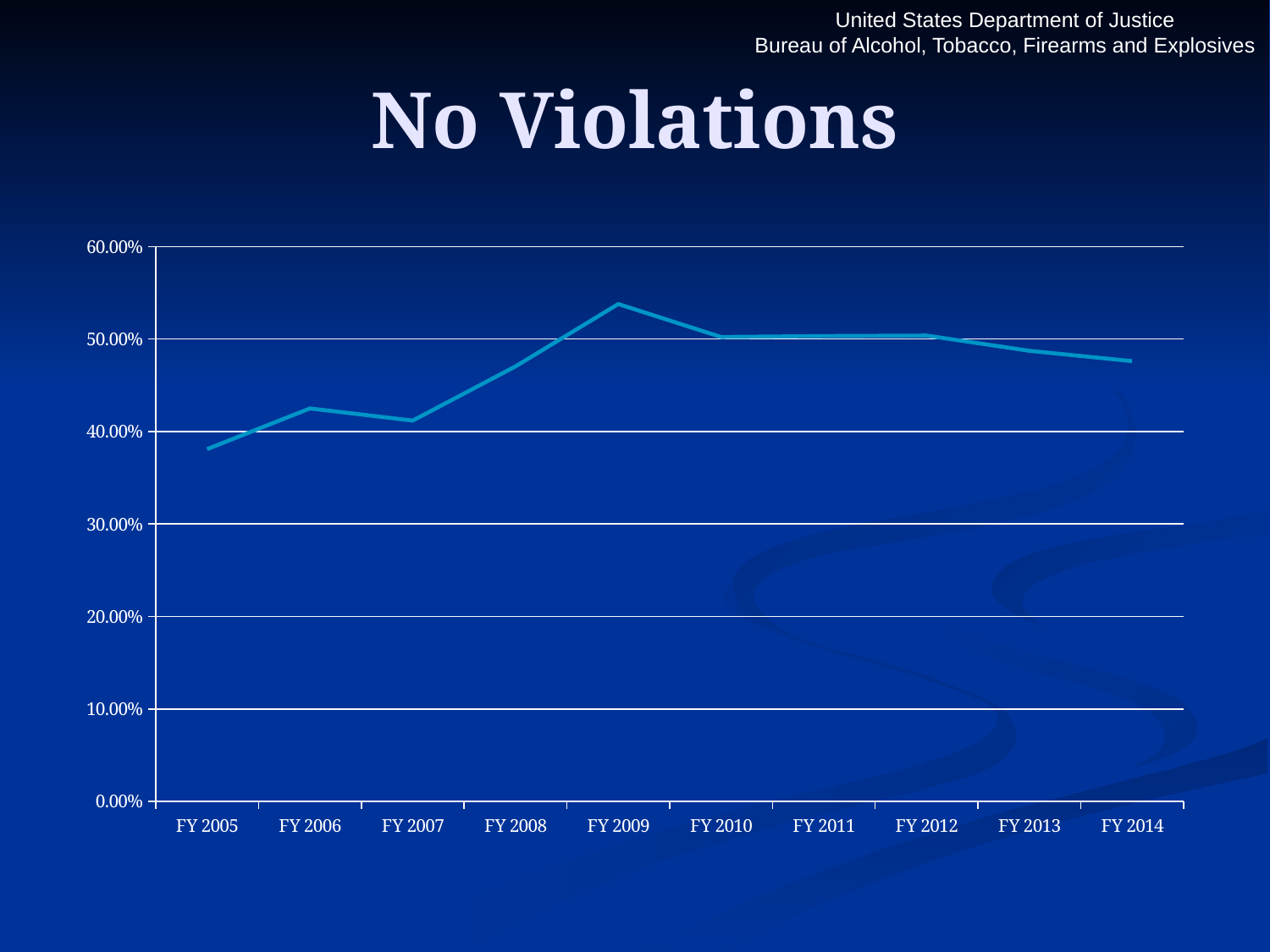
Which fiscal year has the highest value? FY 2009 How many fiscal years are plotted on the x axis? 10 What is the highest value shown on the y axis? 60.00% Does the line rise or fall from FY 2005 to FY 2009? rise Which fiscal year has the lowest value? FY 2005 Is the value for FY 2008 greater or less than 40.00%? greater Is the value for FY 2014 greater or less than 50.00%? less Which is larger, the value for FY 2009 or the value for FY 2005? FY 2009 Is the value for FY 2009 greater or less than 50.00%? greater What kind of chart is shown on the slide? line chart What is the title of the chart? No Violations